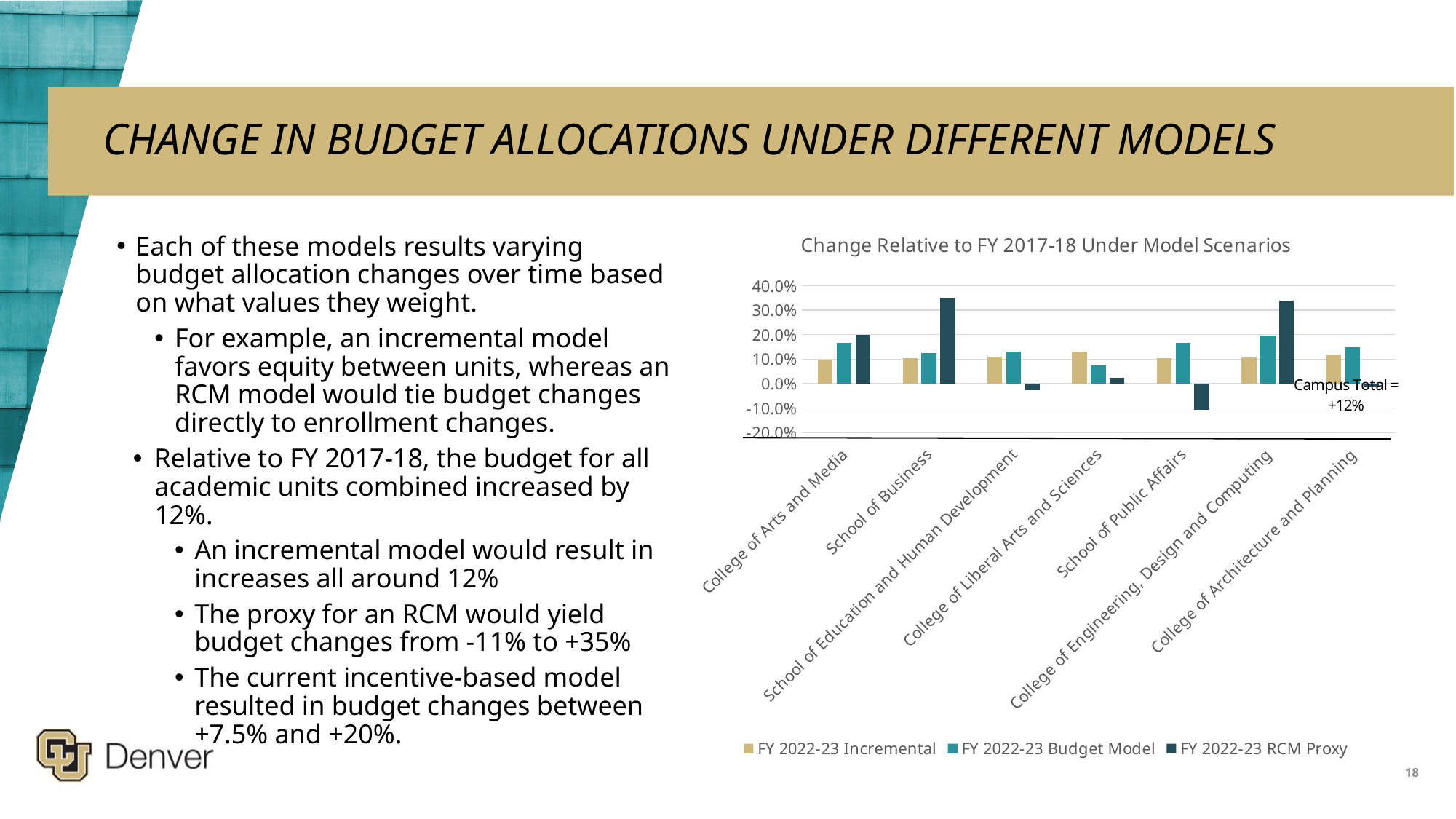
Is the FY 2022-23 RCM Proxy value for the College of Arts and Media greater or less than 10.0%? greater How many academic units (categories) are shown on the x axis of the chart? 7 What is the title of the chart? Change Relative to FY 2017-18 Under Model Scenarios What kind of chart is shown on the slide? Bar chart What campus total is annotated on the chart? +12% Is the FY 2022-23 RCM Proxy value for the School of Public Affairs greater or less than 0.0%? less Which is larger: the FY 2022-23 Budget Model value for the College of Engineering, Design and Computing or for the College of Liberal Arts and Sciences? College of Engineering, Design and Computing Is the FY 2022-23 Budget Model value for the College of Liberal Arts and Sciences greater or less than 10.0%? less How many series does the chart legend list? 3 Which academic unit has the lowest FY 2022-23 RCM Proxy value? School of Public Affairs